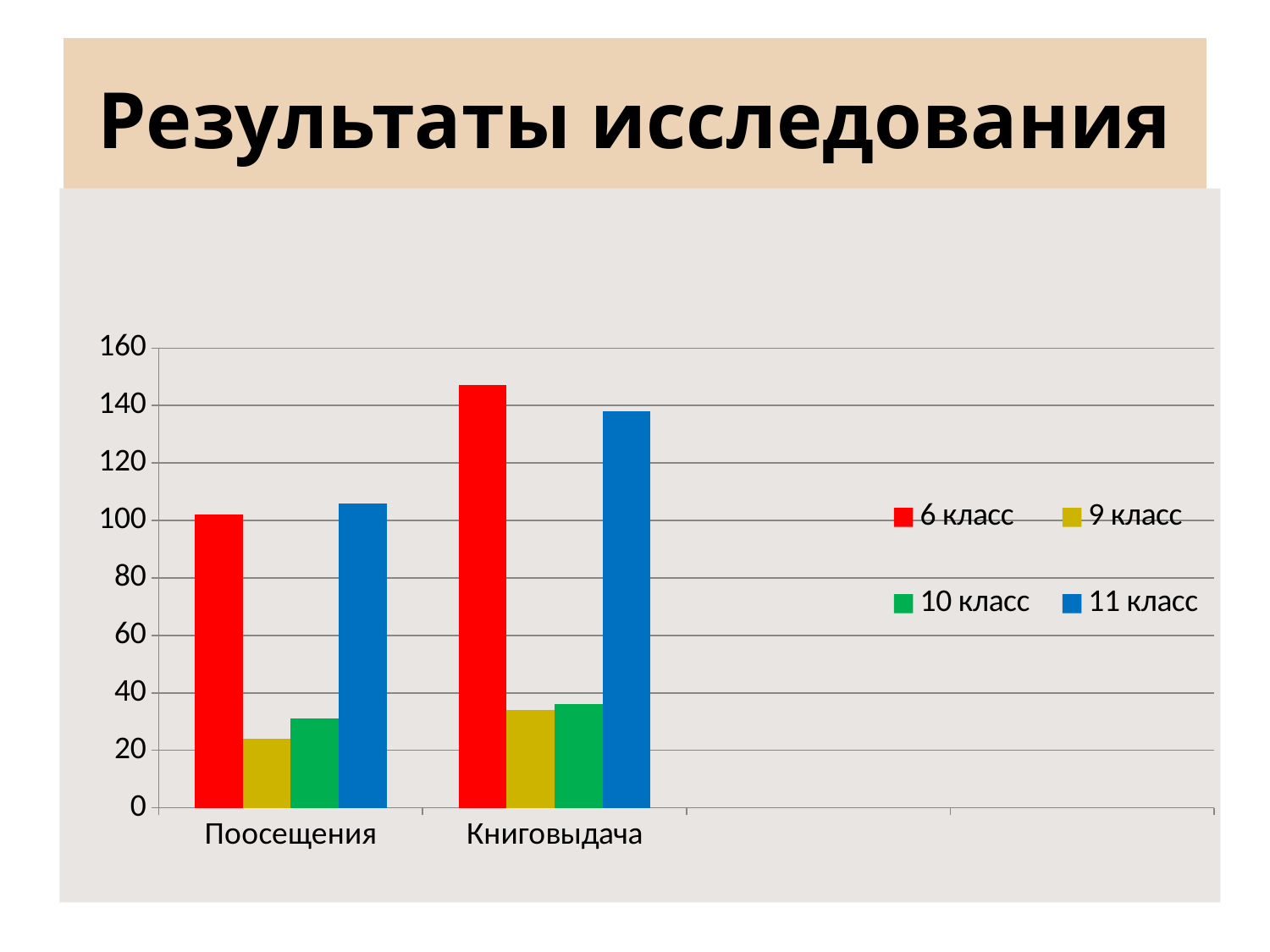
Is the value for 10 класс in Книговыдача greater or less than 40? less Which is larger for 6 класс: Поосещения or Книговыдача? Книговыдача Which is larger in Книговыдача: 11 класс or 10 класс? 11 класс What kind of chart is shown on the slide? bar chart Which series has the lowest value for Поосещения? 9 класс Is the value for 9 класс in Поосещения greater or less than 40? less Which series has the highest value for Книговыдача? 6 класс How many series does the legend list? 4 Is the value for 6 класс in Книговыдача greater or less than 140? greater What is the title of the slide? Результаты исследования How many categories are shown on the x axis? 2